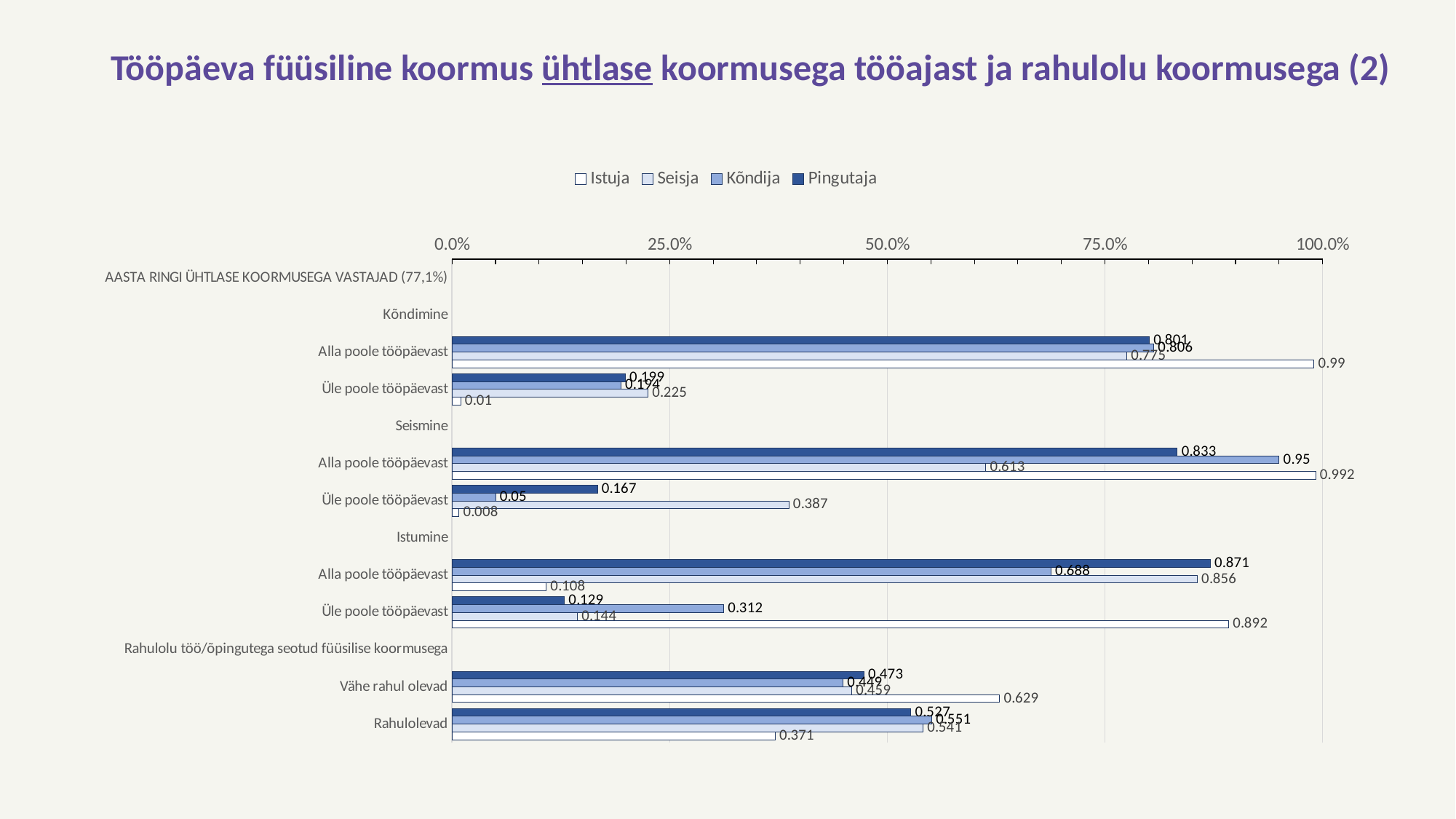
Is the Kõndija value for 'Alla poole tööpäevast' under Istumine greater or less than 50.0%? greater Which series has the highest value for 'Alla poole tööpäevast' under Seismine? Istuja What is the Seisja value for 'Üle poole tööpäevast' under Seismine? 0.387 What is the difference between the Istuja and Kõndija values for 'Üle poole tööpäevast' under Istumine? 0.58 What is the Pingutaja value for 'Alla poole tööpäevast' under Istumine? 0.871 What is the Istuja value for 'Rahulolevad'? 0.371 Which series is shown with the darkest blue bars in the legend? Pingutaja Which series has the lowest value for 'Üle poole tööpäevast' under Seismine? Istuja How many series does the legend list? 4 What is the Istuja value for 'Alla poole tööpäevast' under Kõndimine? 0.99 What kind of chart is shown on the slide? bar chart For 'Vähe rahul olevad', which is larger: the Istuja value or the Pingutaja value? Istuja